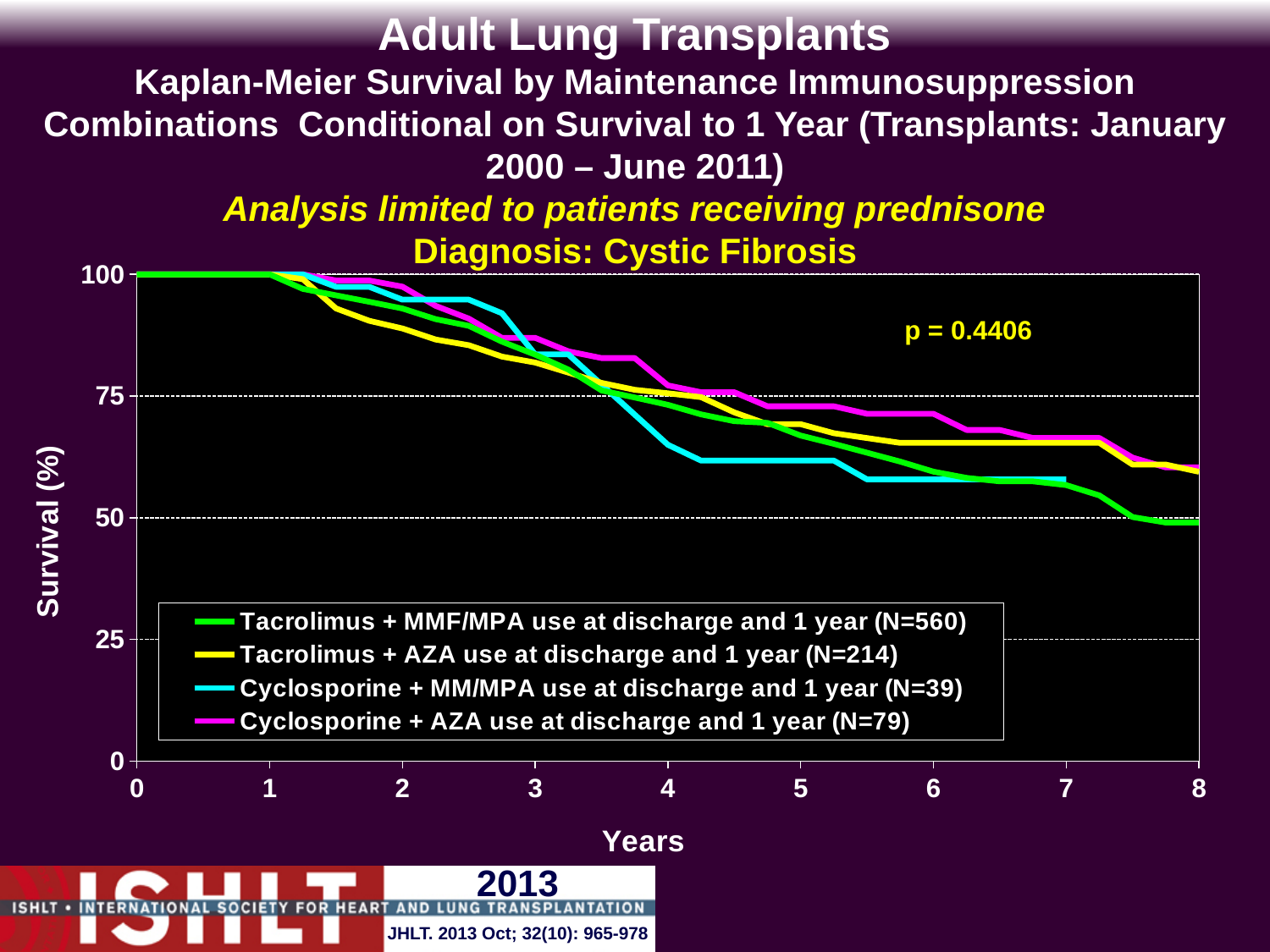
Is the survival for the Cyclosporine + MM/MPA group at 5 years greater or less than 75? less What is the label of the y-axis? Survival (%) What kind of chart is shown on the slide? line chart What p-value is printed on the chart? p = 0.4406 How many series does the legend list? 4 What is the difference in N between the Tacrolimus + MMF/MPA group and the Tacrolimus + AZA group? 346 What is the N for the Cyclosporine + AZA use at discharge and 1 year group? N=79 Which group in the legend has the smallest N? Cyclosporine + MM/MPA use at discharge and 1 year (N=39) Which group in the legend has the largest N? Tacrolimus + MMF/MPA use at discharge and 1 year (N=560) Do the survival curves rise or fall as years increase? fall At 5 years, which curve is higher: Cyclosporine + AZA or Cyclosporine + MM/MPA? Cyclosporine + AZA What is the N for the Tacrolimus + MMF/MPA use at discharge and 1 year group? N=560